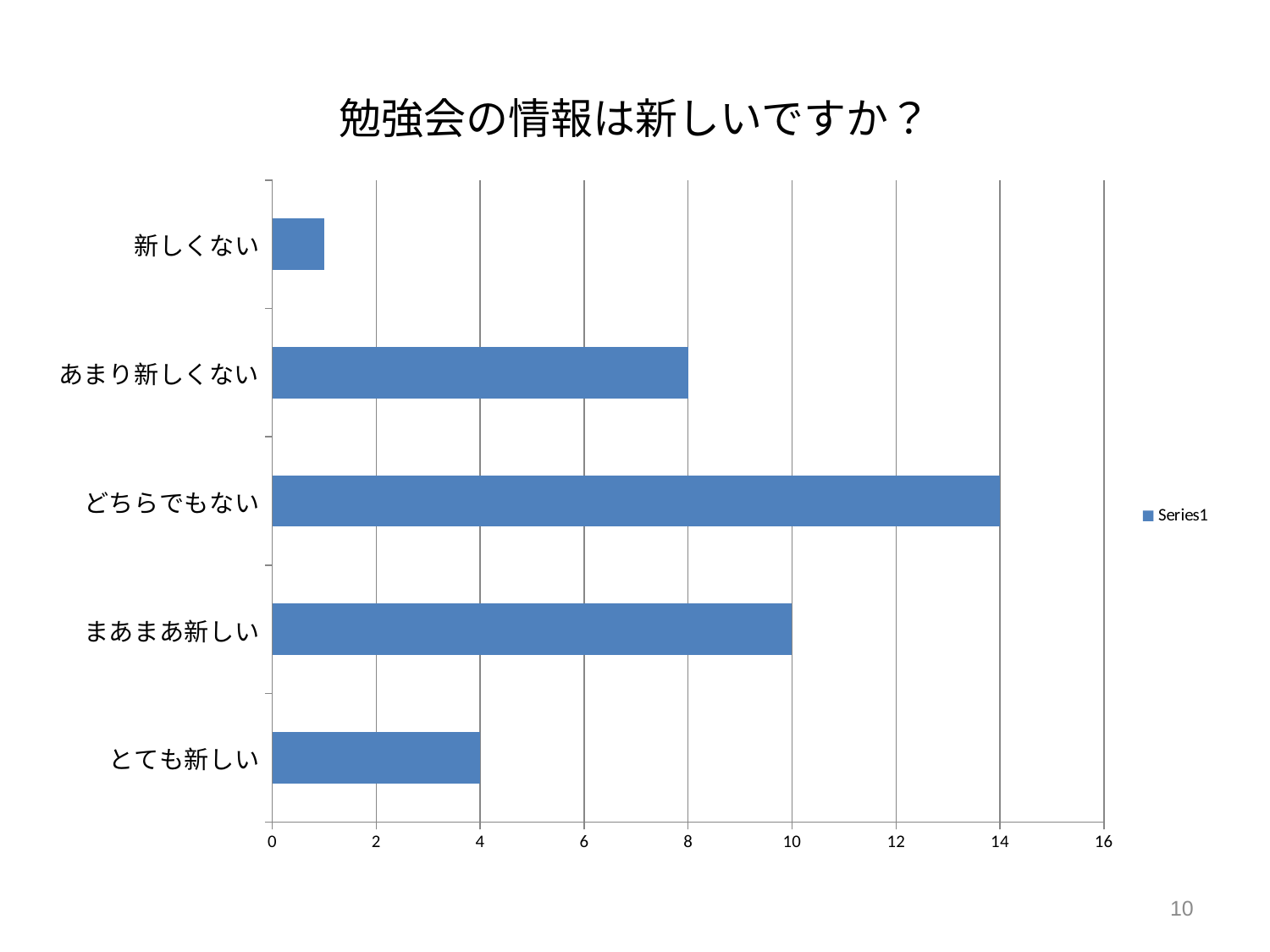
How many categories are shown in the chart? 5 Is the value for 新しくない greater or less than 2? less What is the value for どちらでもない? 14 What is the value for あまり新しくない? 8 Which category has the highest value? どちらでもない What is the difference between the values for どちらでもない and まあまあ新しい? 4 What is the title of the chart? 勉強会の情報は新しいですか？ Which category has the lowest value? 新しくない Which is larger, the value for あまり新しくない or the value for とても新しい? あまり新しくない What kind of chart is shown on the slide? bar chart What is the value for まあまあ新しい? 10 What is the value for とても新しい? 4